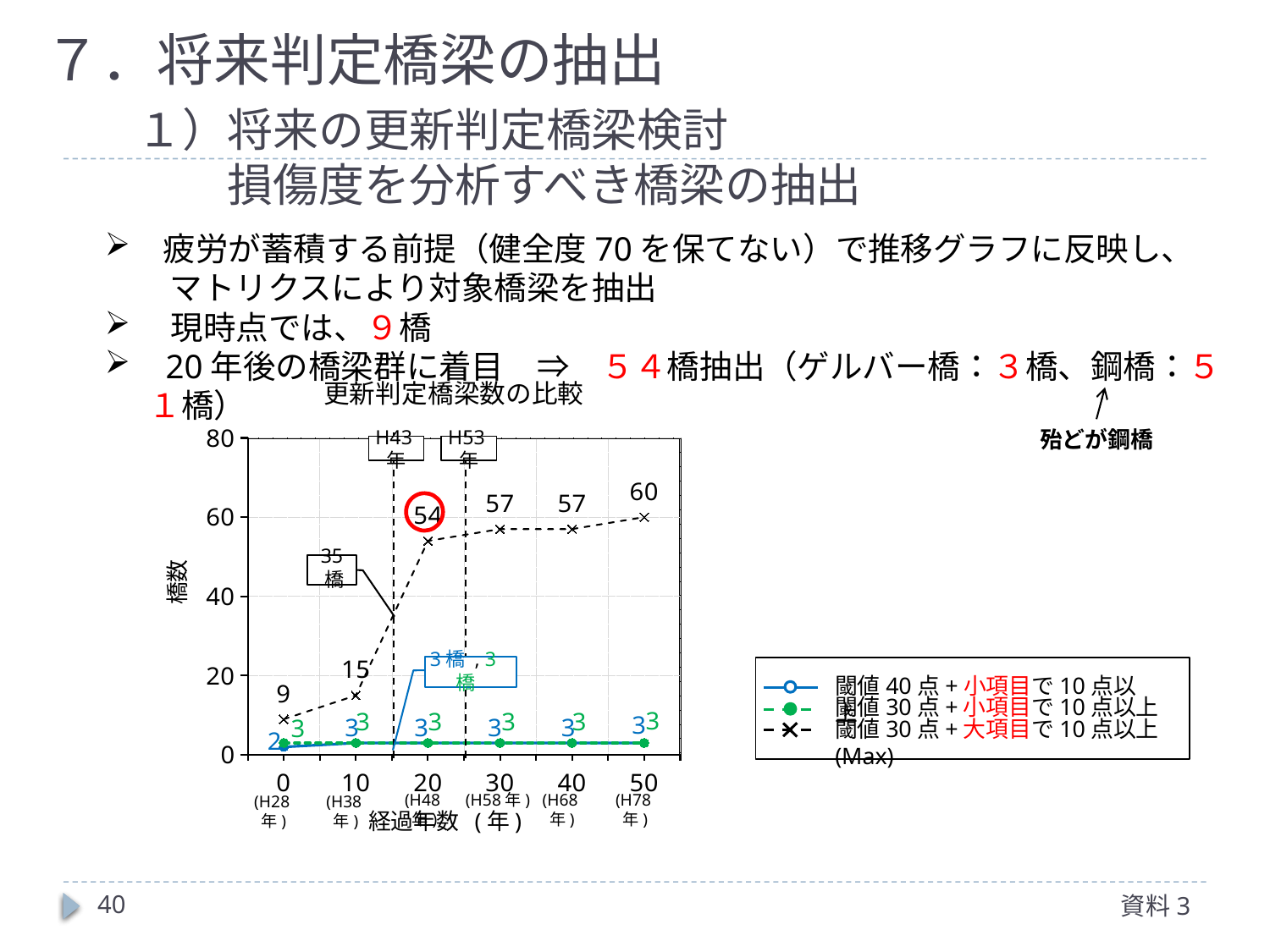
What is the value of the 閾値30点+大項目で10点以上(Max) series at 50 years elapsed? 60 What is the value of the 閾値30点+大項目で10点以上(Max) series at 10 years elapsed? 15 How many series does the chart legend list? 3 What is the value of the 閾値30点+大項目で10点以上(Max) series at 0 years elapsed? 9 Does the 閾値30点+大項目で10点以上(Max) series rise or fall as elapsed years increase? rise How many x-axis points (elapsed-year values) are plotted on the chart? 6 At which elapsed-years point is the 閾値30点+大項目で10点以上(Max) series highest? 50 What is the label on the x axis of the chart? 経過年数（年） What kind of chart is shown on the slide? line chart What is the difference between the 閾値30点+大項目で10点以上(Max) values at 20 years and 10 years? 39 What is the value of the 閾値30点+大項目で10点以上(Max) series at 20 years elapsed? 54 What is the title of the chart? 更新判定橋梁数の比較